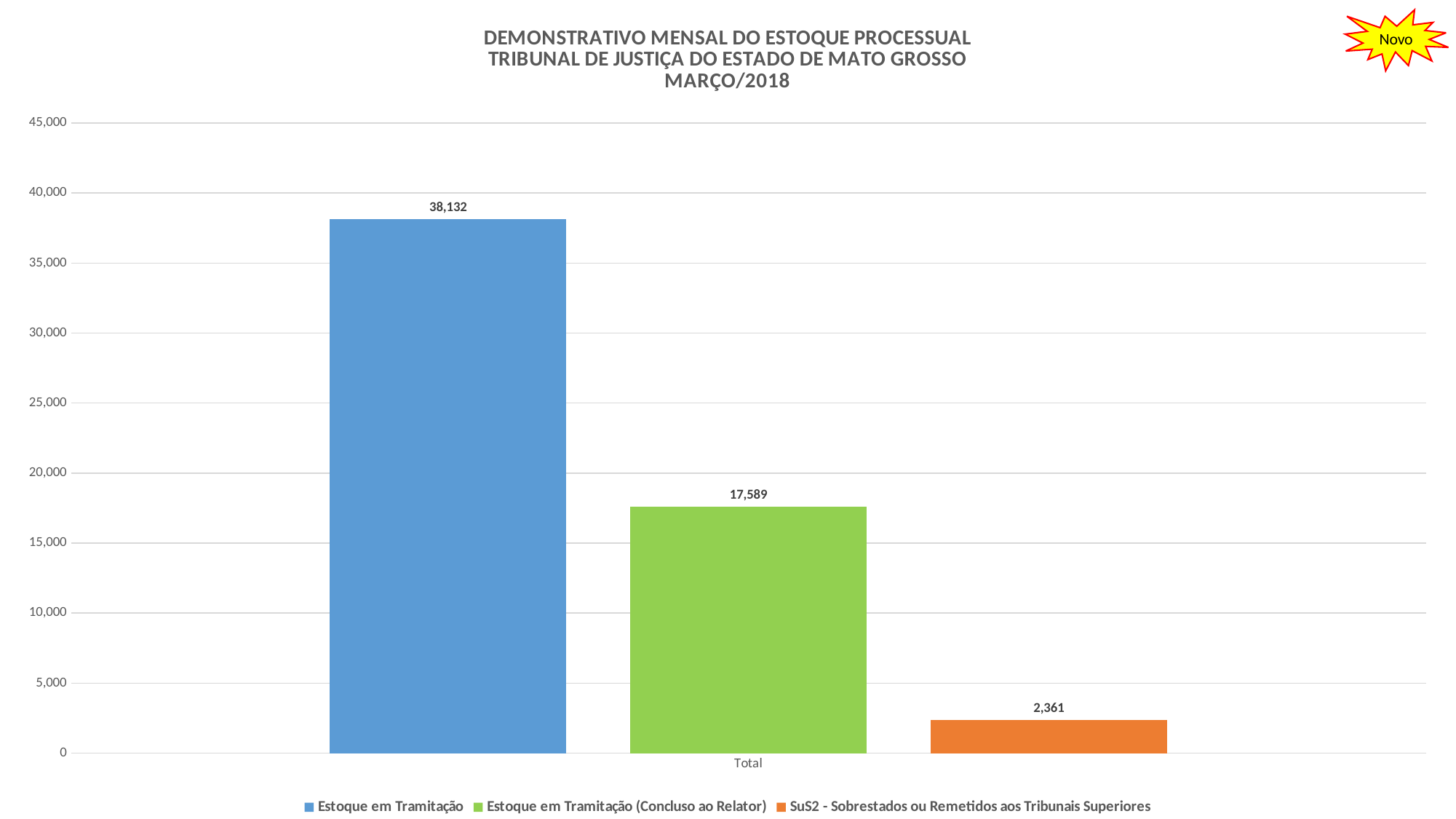
What is the difference between Estoque em Tramitação and Estoque em Tramitação (Concluso ao Relator)? 20,543 What is the difference between Estoque em Tramitação (Concluso ao Relator) and SuS2 - Sobrestados ou Remetidos aos Tribunais Superiores? 15,228 What is the value for Estoque em Tramitação? 38,132 Which is larger, Estoque em Tramitação (Concluso ao Relator) or SuS2 - Sobrestados ou Remetidos aos Tribunais Superiores? Estoque em Tramitação (Concluso ao Relator) How many series does the legend list? 3 What is the value for Estoque em Tramitação (Concluso ao Relator)? 17,589 What is the value for SuS2 - Sobrestados ou Remetidos aos Tribunais Superiores? 2,361 Which series has the lowest value? SuS2 - Sobrestados ou Remetidos aos Tribunais Superiores What kind of chart is shown on the slide? bar chart What colour is the bar for SuS2 - Sobrestados ou Remetidos aos Tribunais Superiores? orange Is the value for Estoque em Tramitação greater or less than 35,000? greater Which series has the highest value? Estoque em Tramitação